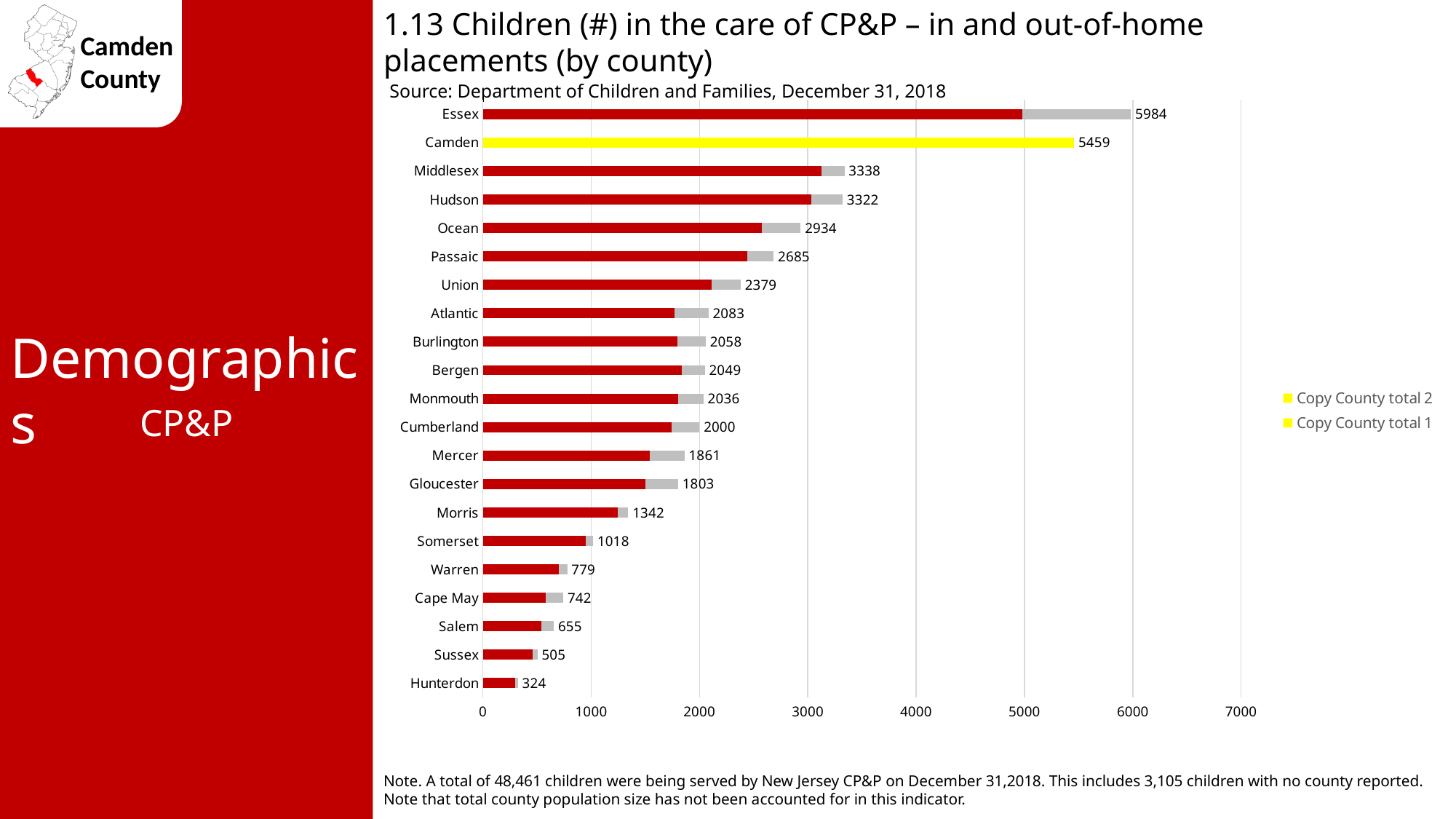
Which county has a larger total, Middlesex or Hudson? Middlesex Is the total for Ocean county greater or less than 3000? less Which county has the lowest total number of children in the care of CP&P? Hunterdon What is the difference between the totals for Essex and Camden? 525 What is the total number of children in the care of CP&P for Camden county? 5459 Which county's bar is highlighted in yellow? Camden How many counties are shown on the chart? 21 What is the total value shown for Essex county? 5984 How many entries does the legend list? 2 Which county has the highest total number of children in the care of CP&P? Essex What kind of chart is shown on the slide? bar chart What is the total value shown for Gloucester county? 1803